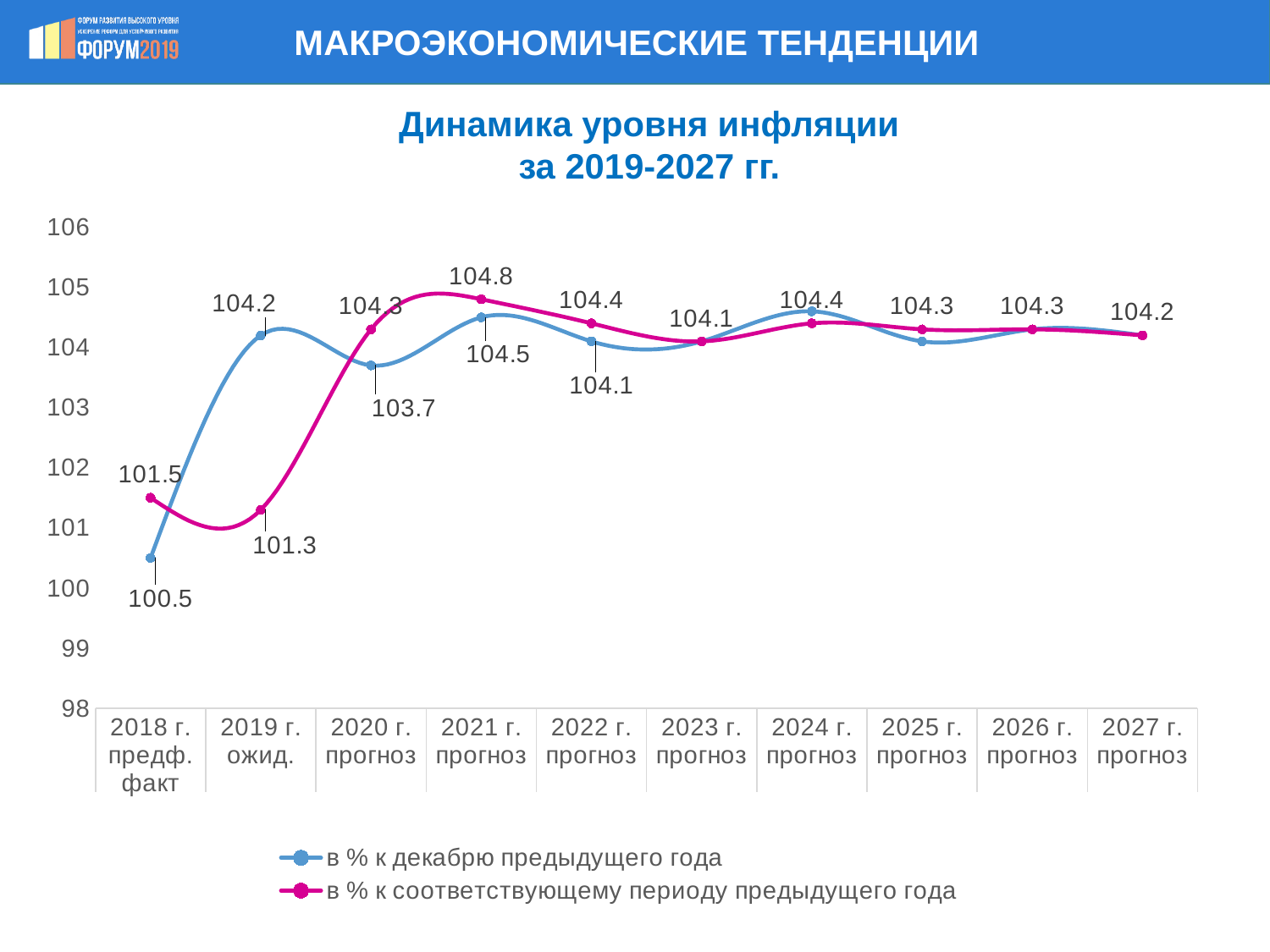
Does the series 'в % к декабрю предыдущего года' rise or fall from 2018 г. предф. факт to 2019 г. ожид.? Rise In which year does the series 'в % к соответствующему периоду предыдущего года' reach its highest value? 2021 г. прогноз What kind of chart is shown on the slide? Line chart What is the value of the series 'в % к декабрю предыдущего года' for 2020 г. прогноз? 103.7 What is the value of the series 'в % к соответствующему периоду предыдущего года' for 2021 г. прогноз? 104.8 How many year categories are shown on the x axis? 10 How many series does the legend list? 2 What is the value of the series 'в % к соответствующему периоду предыдущего года' for 2019 г. ожид.? 101.3 What is the difference between the two series' values for 2018 г. предф. факт? 1.0 For 2019 г. ожид., which series has the larger value? в % к декабрю предыдущего года What is the value of the series 'в % к декабрю предыдущего года' for 2018 г. предф. факт? 100.5 In which year does the series 'в % к декабрю предыдущего года' have its lowest value? 2018 г. предф. факт